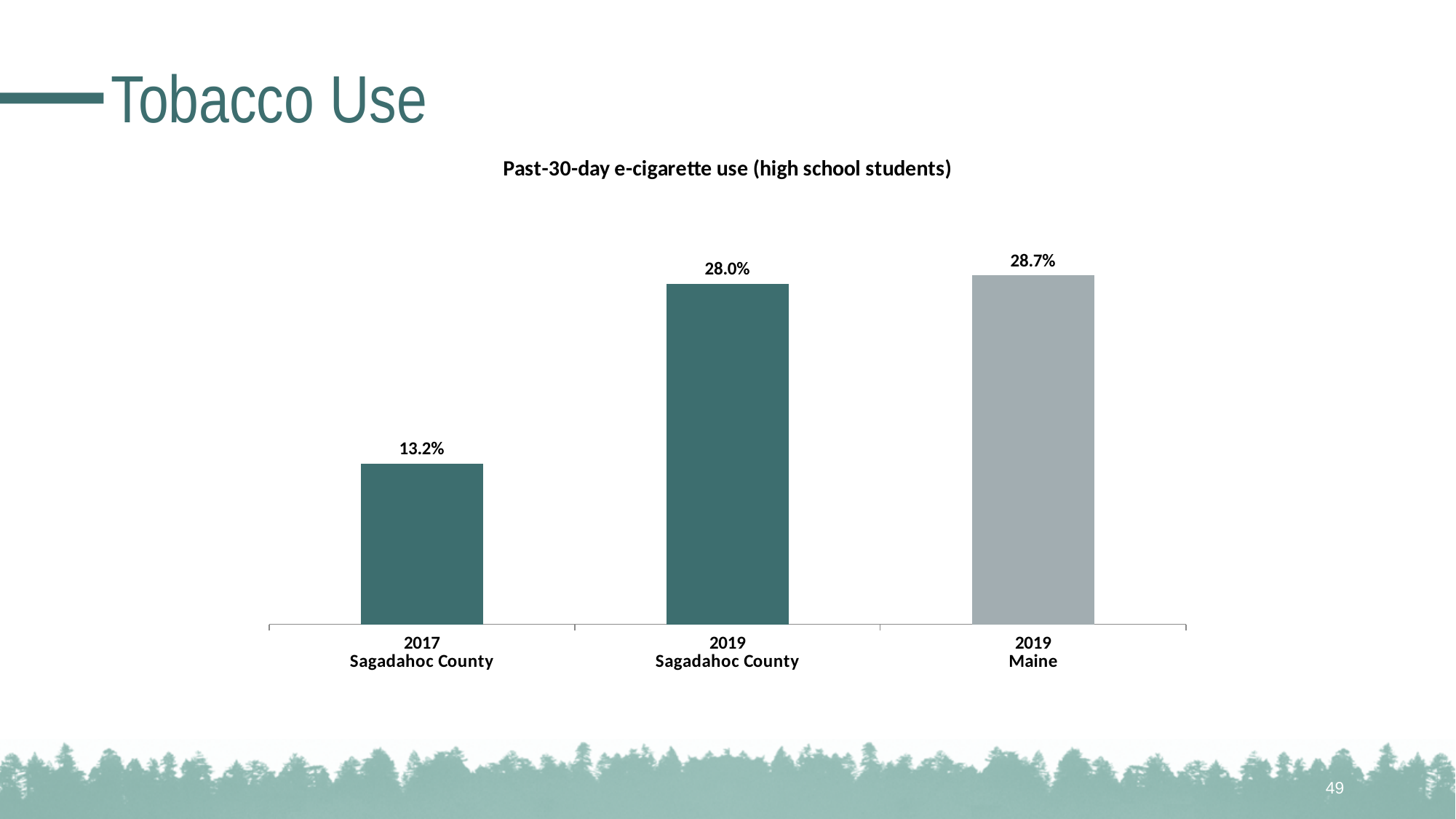
What is the difference between the 2019 Maine value and the 2019 Sagadahoc County value? 0.7% Which category has the highest value in the chart? 2019 Maine What is the title of the chart? Past-30-day e-cigarette use (high school students) What is the past-30-day e-cigarette use value for 2019 Maine? 28.7% What is the past-30-day e-cigarette use value for 2019 Sagadahoc County? 28.0% How many bars are shown in the chart? 3 Which category has the lowest value in the chart? 2017 Sagadahoc County What kind of chart is shown on the slide? Bar chart Did past-30-day e-cigarette use in Sagadahoc County rise or fall from 2017 to 2019? Rise What is the difference between the 2019 Sagadahoc County value and the 2017 Sagadahoc County value? 14.8% What is the past-30-day e-cigarette use value for 2017 Sagadahoc County? 13.2% Which is larger, the value for 2017 Sagadahoc County or the value for 2019 Sagadahoc County? 2019 Sagadahoc County